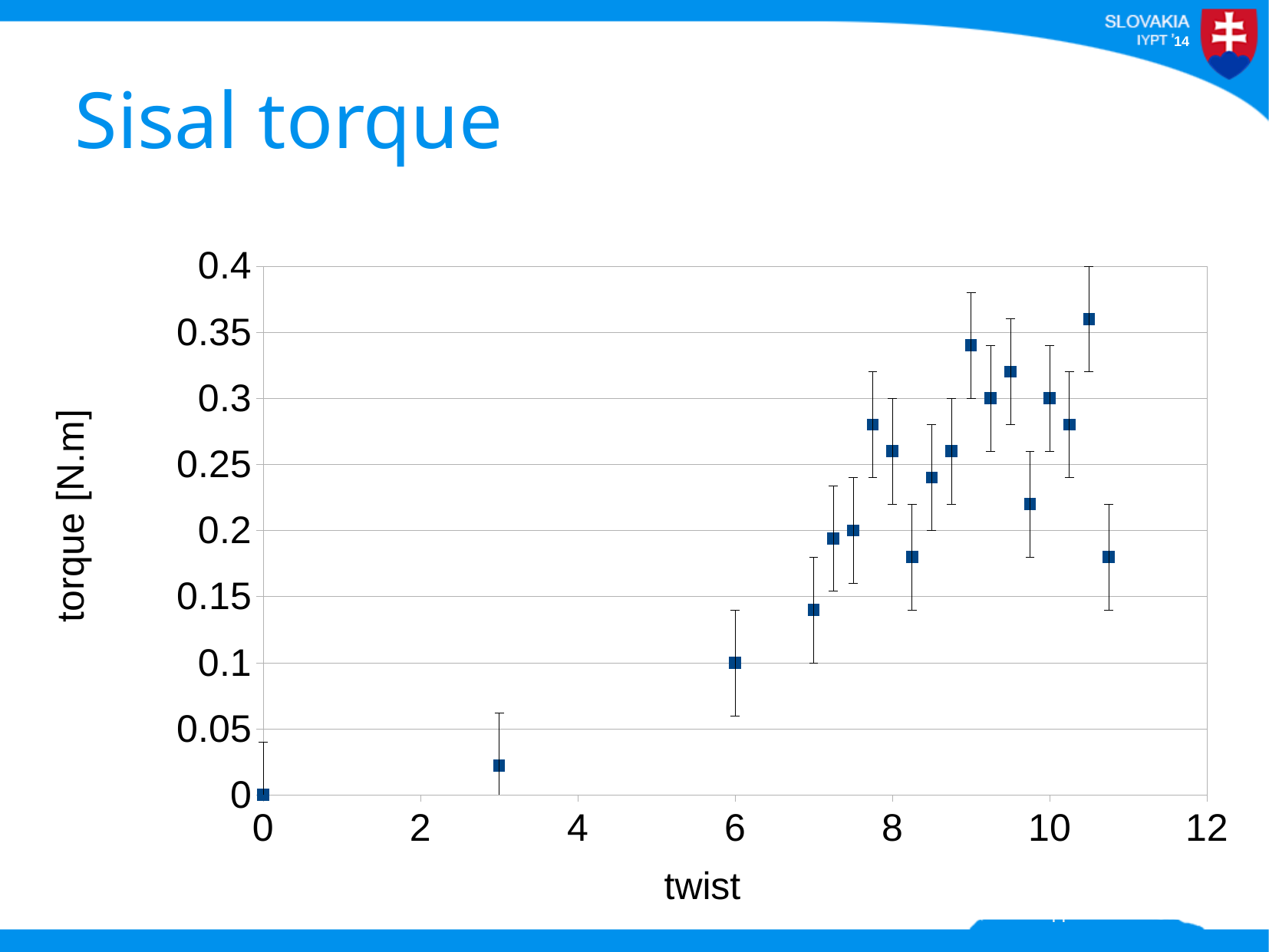
Which has the larger torque, the point at twist 6 or the point at twist 9? twist 9 What is the torque value at twist 0? 0 What is the torque value at twist 6? 0.1 Is the torque value at twist 7 greater or less than 0.15? less What type of chart is shown on the slide? Scatter plot Is the torque value at twist 9 greater or less than 0.3? greater What is the label of the y axis? torque [N.m] What is the title of the chart? Sisal torque Does the torque generally rise or fall as twist increases from 0 to 9? rise At which twist value is the torque lowest? 0 Is the torque value at twist 10.5 greater or less than 0.35? greater